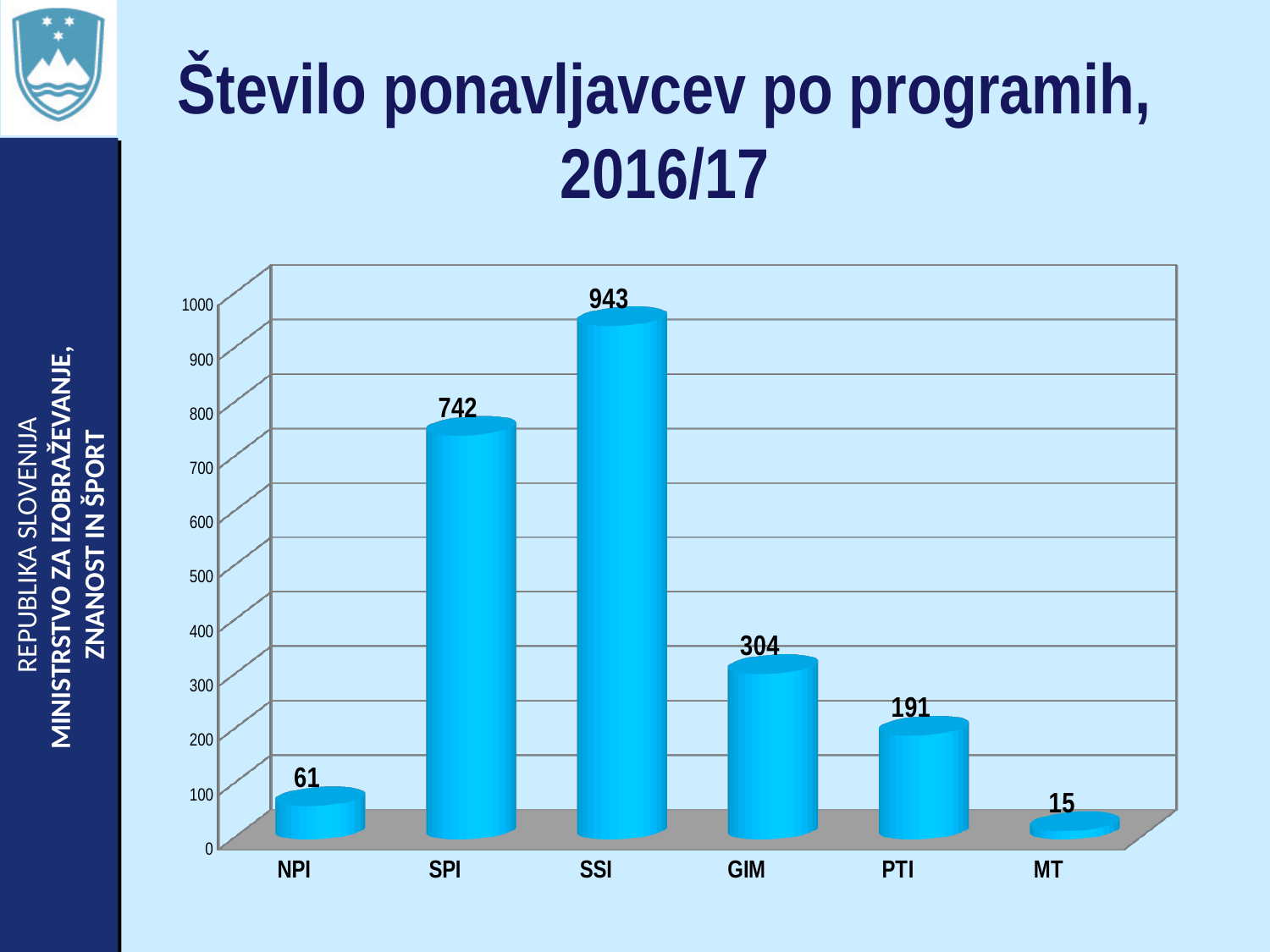
How many programs are shown on the x axis? 6 Is the value for GIM greater or less than 400? less What kind of chart is shown on the slide? bar chart What is the value for SSI? 943 What is the value for PTI? 191 What is the difference between the values for GIM and PTI? 113 Which program has the highest number of repeaters? SSI Which program has the lowest number of repeaters? MT What is the difference between the values for SSI and SPI? 201 What is the title of the chart on the slide? Število ponavljavcev po programih, 2016/17 Which is larger, the value for SPI or the value for GIM? SPI What is the value for NPI? 61